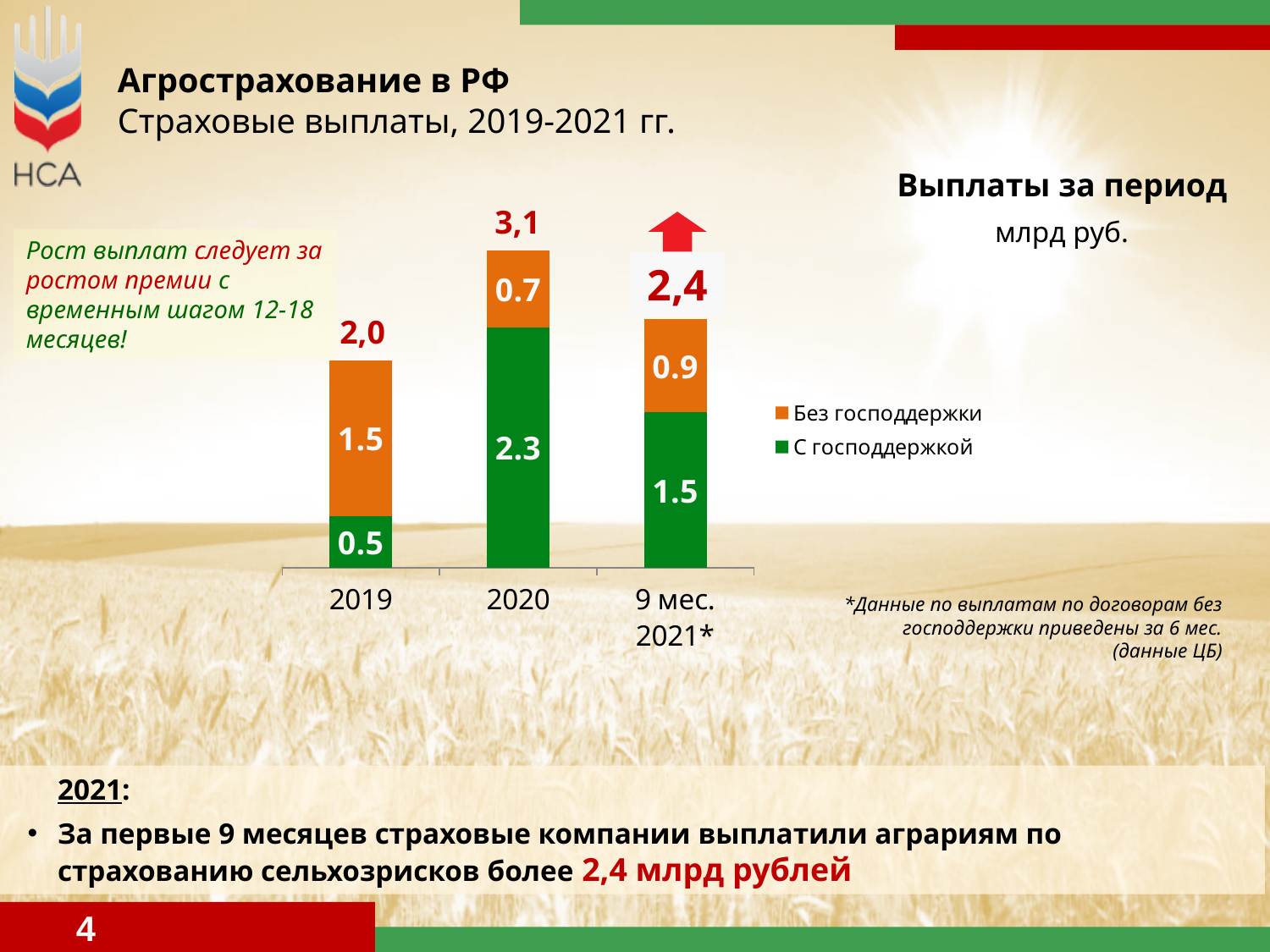
What is the value for 'С господдержкой' in 2020? 2.3 What is the total of the stacked bar for 2020? 3,1 How many series does the chart legend list? 2 What type of chart is shown on the slide? stacked bar chart What is the total of the stacked bar for 2019? 2,0 What is the value for 'Без господдержки' in 2019? 1.5 Which is larger: 'Без господдержки' in 2020 or 'Без господдержки' for 9 мес. 2021*? 9 мес. 2021* How many categories are shown on the x axis of the chart? 3 Which category has the lowest value for 'С господдержкой'? 2019 What is the difference between the 'С господдержкой' values for 2020 and 2019? 1.8 What is the value for 'С господдержкой' for 9 мес. 2021*? 1.5 Which year has the highest total payouts? 2020